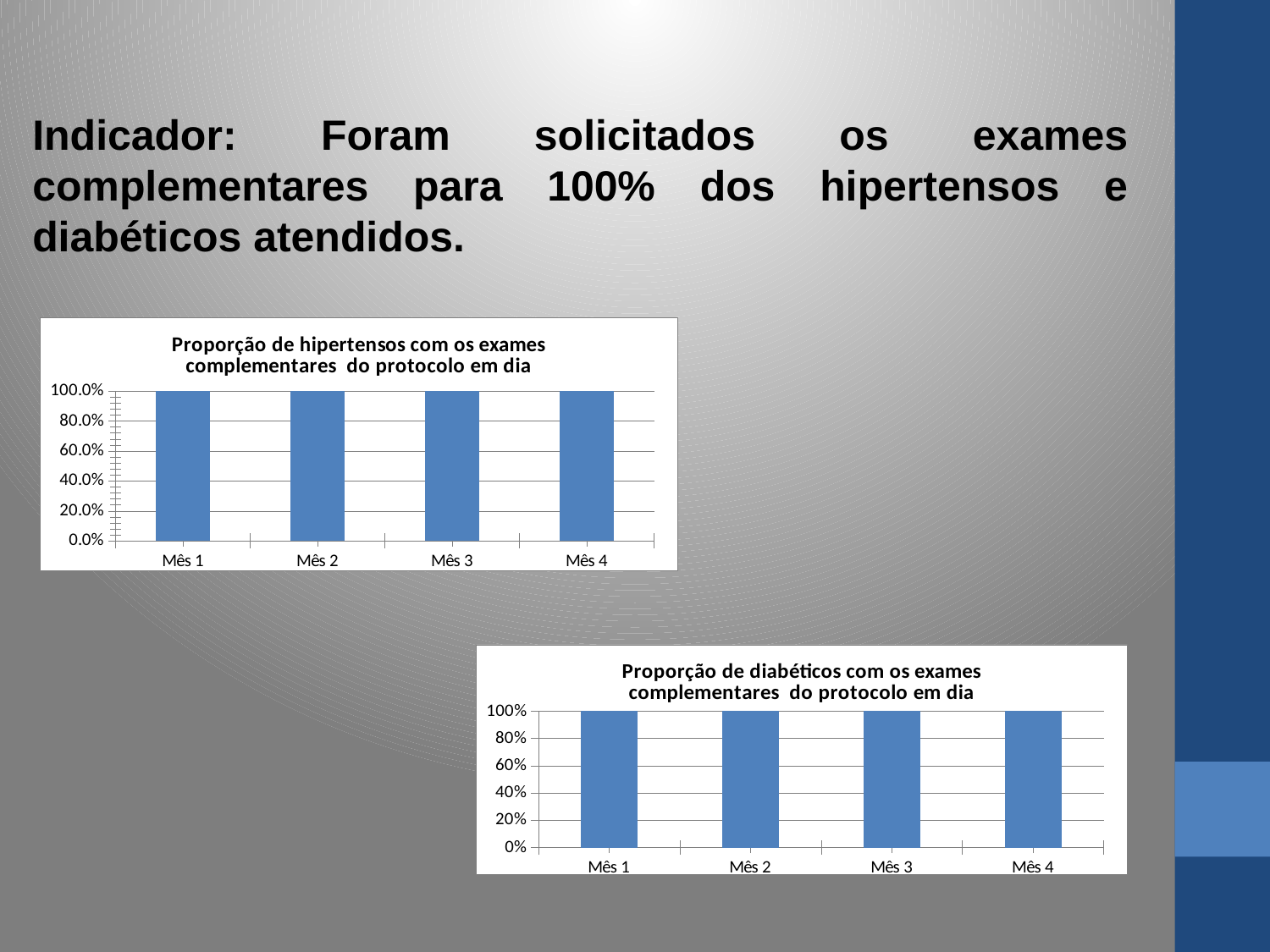
How many categories are shown on the x axis of the chart titled 'Proporção de hipertensos com os exames complementares do protocolo em dia'? 4 In the chart titled 'Proporção de diabéticos com os exames complementares do protocolo em dia', what is the value for Mês 2? 100% In the chart titled 'Proporção de hipertensos com os exames complementares do protocolo em dia', what is the value for Mês 1? 100.0% What kind of chart is the lower chart on the slide? Bar chart In the chart titled 'Proporção de hipertensos com os exames complementares do protocolo em dia', what is the difference between the values for Mês 2 and Mês 4? 0.0% In the chart titled 'Proporção de diabéticos com os exames complementares do protocolo em dia', is the value for Mês 3 greater or less than 80%? greater What is the title of the lower chart on the slide? Proporção de diabéticos com os exames complementares do protocolo em dia In the chart titled 'Proporção de diabéticos com os exames complementares do protocolo em dia', what is the value for Mês 4? 100% In the chart titled 'Proporção de hipertensos com os exames complementares do protocolo em dia', what is the value for Mês 3? 100.0% What kind of chart is the upper chart on the slide? Bar chart How many bars are plotted in the chart titled 'Proporção de diabéticos com os exames complementares do protocolo em dia'? 4 In the chart titled 'Proporção de hipertensos com os exames complementares do protocolo em dia', do the values rise, fall or stay the same from Mês 1 to Mês 4? Stay the same